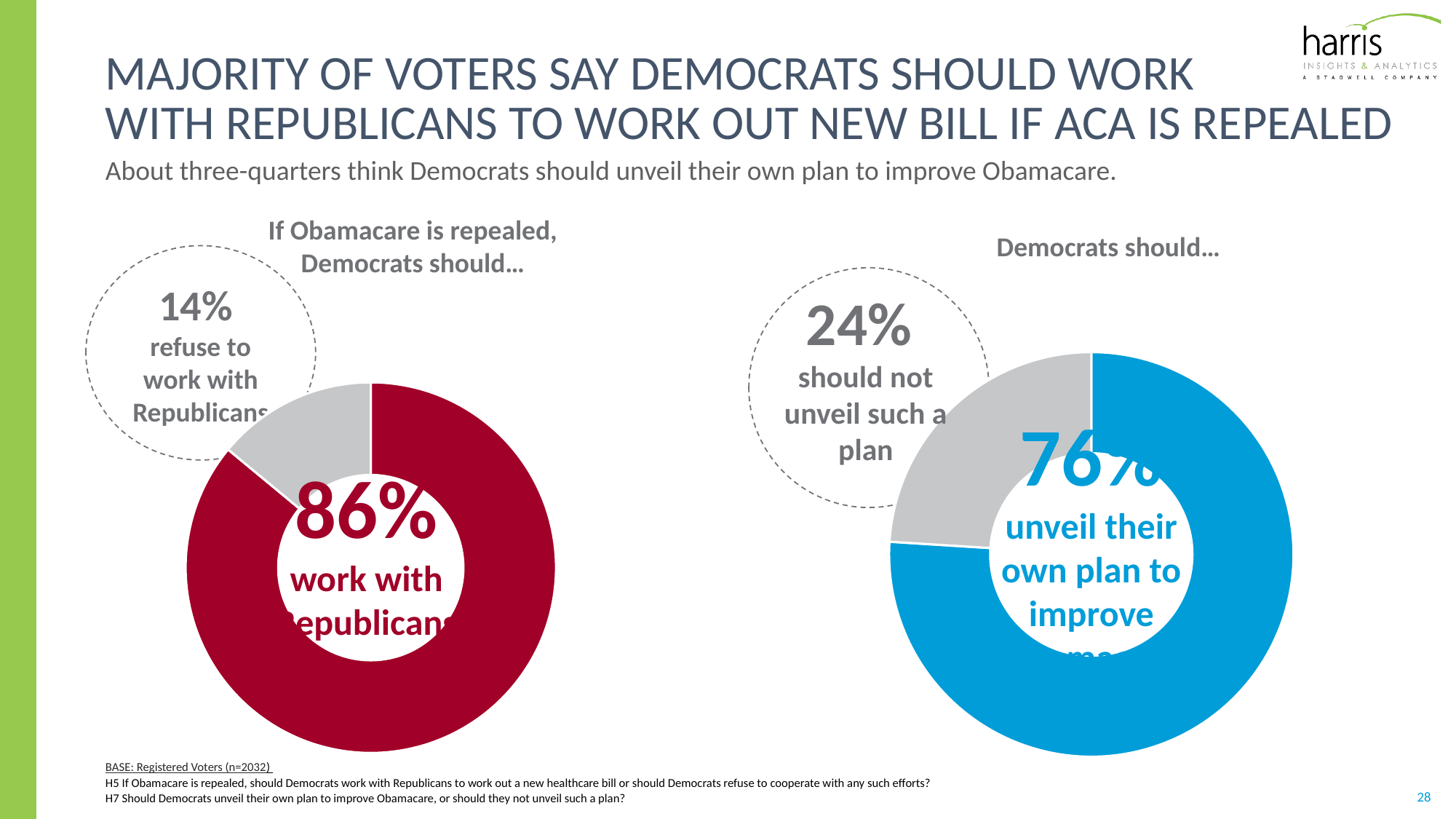
What kind of chart is used on the left side of the slide? Donut (pie) chart In the left chart titled 'If Obamacare is repealed, Democrats should...', which response is the largest? Work with Republicans Which is larger: the share saying Democrats should work with Republicans in the left chart, or the share saying Democrats should unveil their own plan in the right chart? Work with Republicans (86%) In the left chart titled 'If Obamacare is repealed, Democrats should...', what share of voters say Democrats should refuse to work with Republicans? 14% How many segments does the right chart titled 'Democrats should...' have? 2 In the right chart titled 'Democrats should...', what share of voters say Democrats should unveil their own plan to improve Obamacare? 76% In the left chart titled 'If Obamacare is repealed, Democrats should...', what is the difference in percentage points between those who say work with Republicans and those who say refuse to work with Republicans? 72 percentage points In the right chart titled 'Democrats should...', what is the difference in percentage points between those who say unveil their own plan and those who say should not unveil such a plan? 52 percentage points In the right chart titled 'Democrats should...', what share of voters say Democrats should not unveil such a plan? 24% In the right chart titled 'Democrats should...', which response is the smallest? Should not unveil such a plan In the left chart titled 'If Obamacare is repealed, Democrats should...', what share of voters say Democrats should work with Republicans? 86% What colour is the largest segment in the right chart titled 'Democrats should...'? Blue